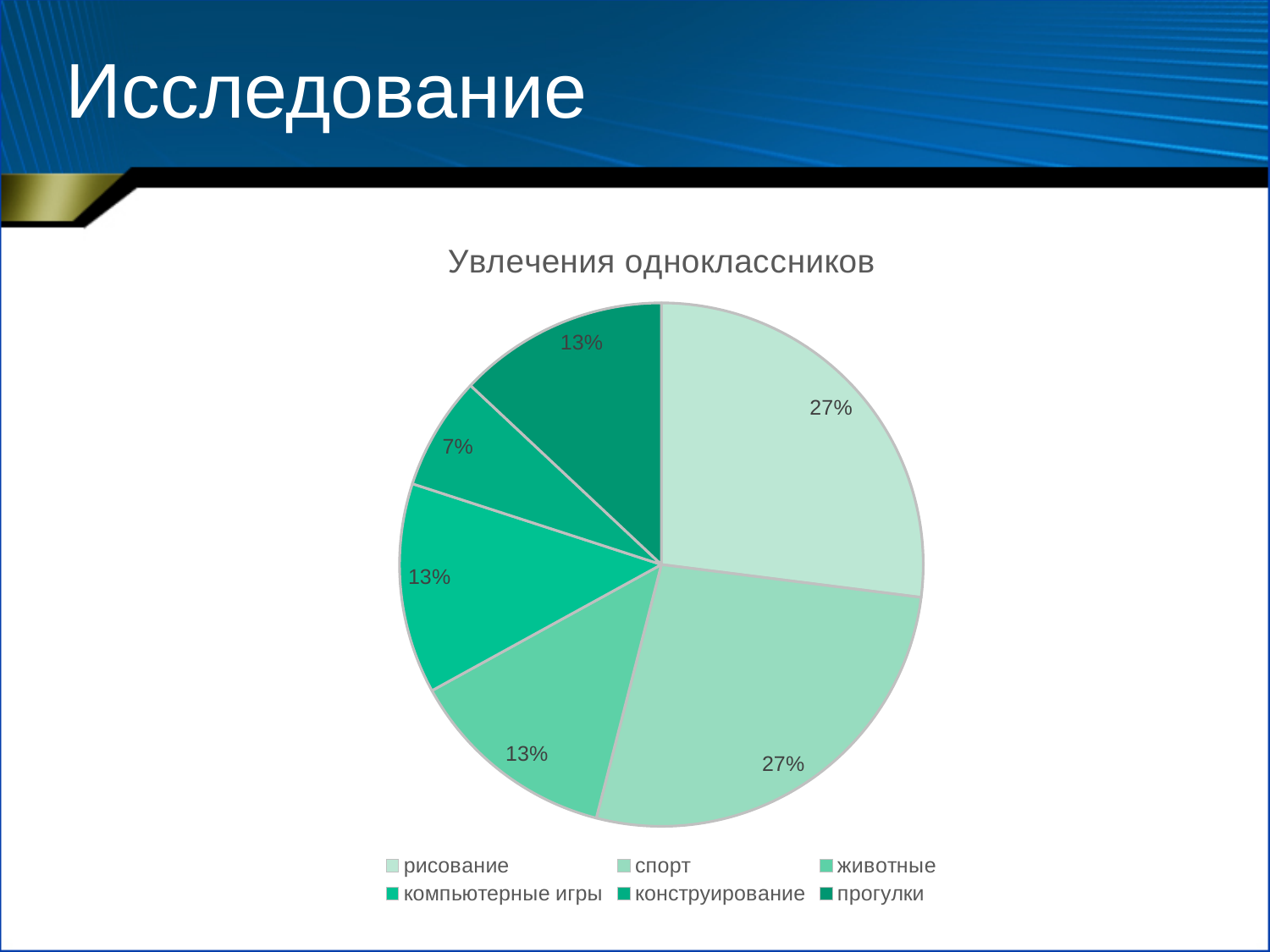
What is the value shown for животные? 13% How many entries does the legend list? 6 What is the difference between the share for спорт and the share for конструирование? 20% What share of the pie does рисование take? 27% What is the title of the chart? Увлечения одноклассников How many slices does the pie chart have? 6 Which category has the smallest slice of the pie? конструирование What kind of chart is shown on the slide? pie chart What share of the pie does конструирование take? 7% What share of the pie does спорт take? 27% Which is larger, the slice for компьютерные игры or the slice for конструирование? компьютерные игры